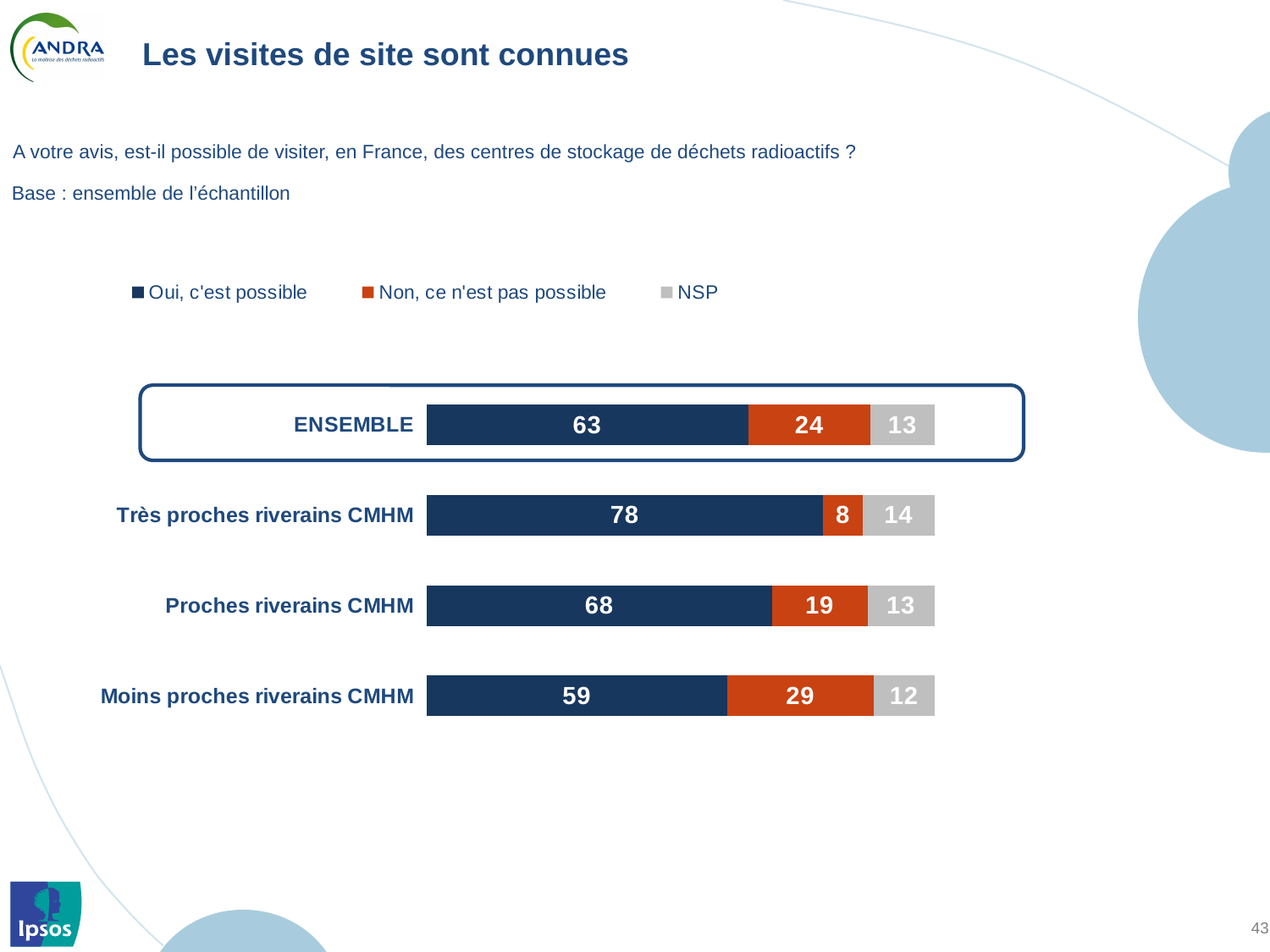
Which legend entry is shown in orange? Non, ce n'est pas possible How many categories are shown in the chart? 4 What is the NSP value for Très proches riverains CMHM? 14 What is the value for "Non, ce n'est pas possible" for Moins proches riverains CMHM? 29 Which is larger: the "Non, ce n'est pas possible" value for Proches riverains CMHM or for ENSEMBLE? ENSEMBLE Which category has the lowest value for "Non, ce n'est pas possible"? Très proches riverains CMHM What kind of chart is shown on the slide? Stacked bar chart What is the total of the stacked bar for Proches riverains CMHM? 100 Which category has the highest value for "Oui, c'est possible"? Très proches riverains CMHM What is the value for "Oui, c'est possible" for ENSEMBLE? 63 How many series does the legend list? 3 What is the difference between the "Oui, c'est possible" values for Très proches riverains CMHM and Moins proches riverains CMHM? 19